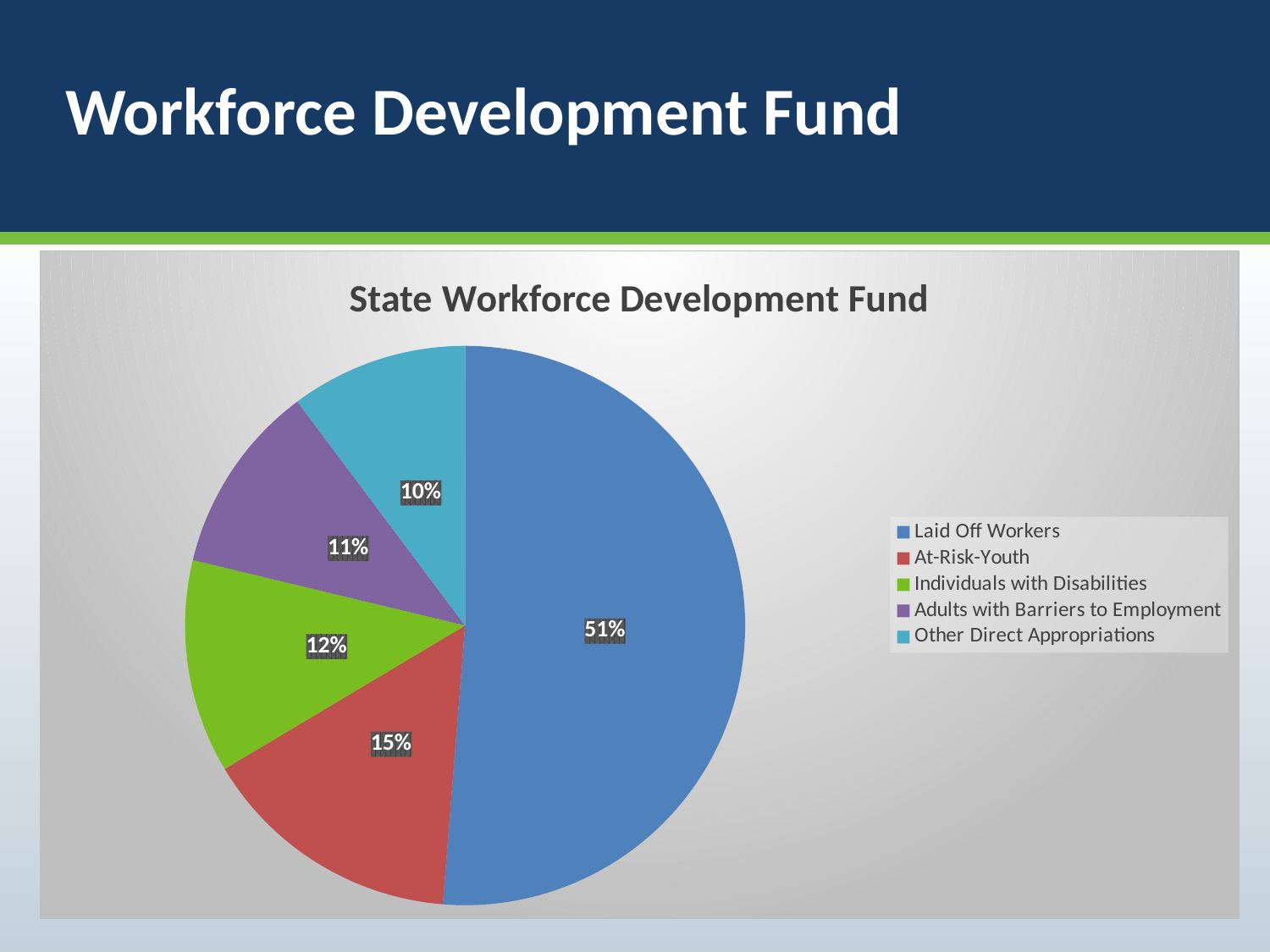
Which category has the smallest share of the pie? Other Direct Appropriations What is the title of the chart? State Workforce Development Fund What share of the pie is At-Risk-Youth? 15% Which category has the largest share of the pie? Laid Off Workers Which is larger, the share for At-Risk-Youth or the share for Individuals with Disabilities? At-Risk-Youth How many categories does the pie chart show? 5 What share of the pie is Adults with Barriers to Employment? 11% What is the difference in percentage points between Laid Off Workers and At-Risk-Youth? 36 What share of the pie is Laid Off Workers? 51% What type of chart is shown on the slide? pie chart